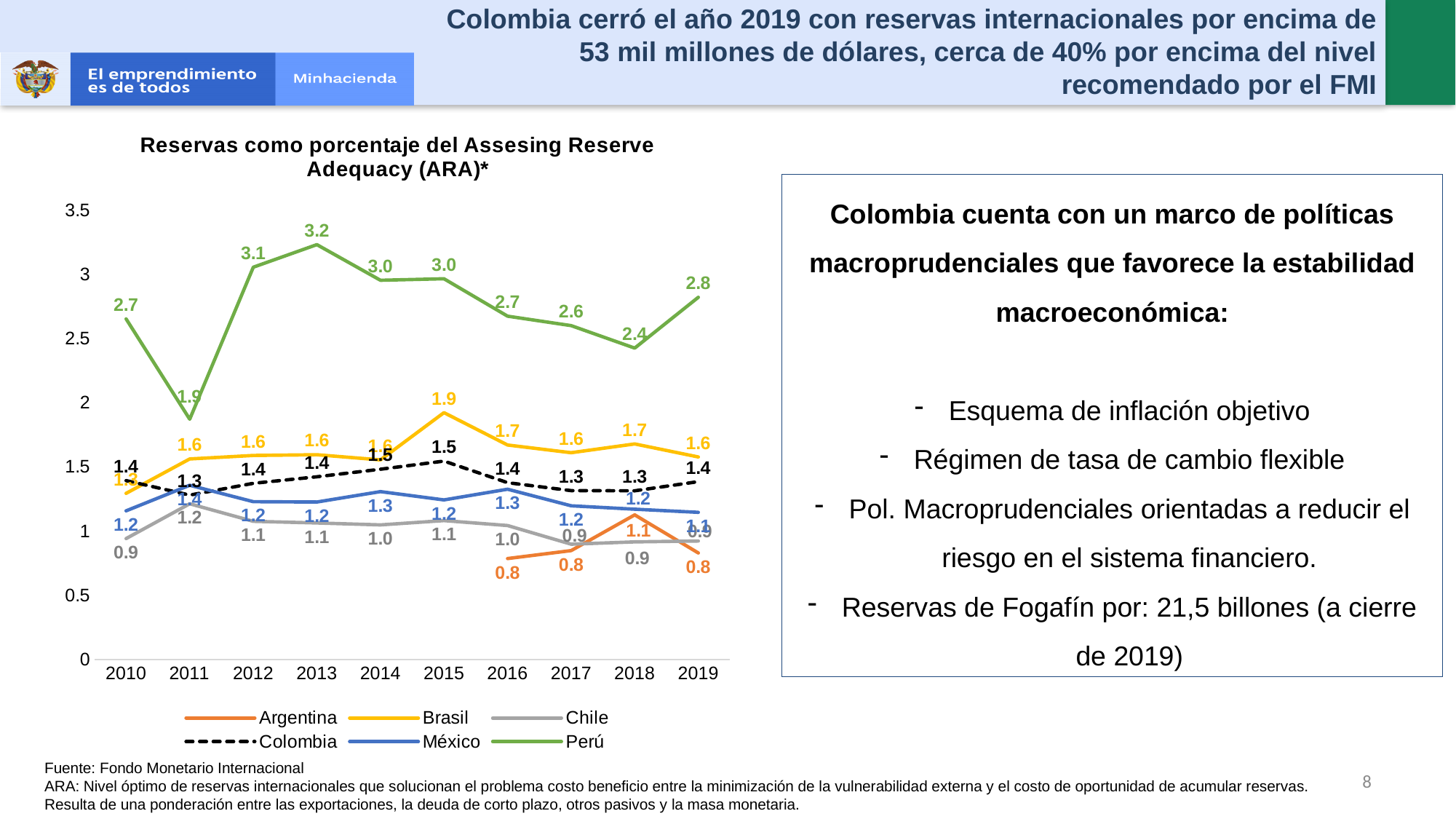
In which year does Perú have its lowest value? 2011 Do Perú's values rise or fall from 2015 to 2018? fall What is the difference between Perú's value in 2013 and its value in 2011? 1.3 How many years are shown on the x axis of the chart? 10 Which is larger in 2019, the value for Perú or the value for Brasil? Perú What is the value for Brasil in 2015? 1.9 What is the value for Argentina in 2018? 1.1 What is the value for Perú in 2013? 3.2 How many series does the legend of the chart list? 6 What is the value for Colombia in 2019? 1.4 What kind of chart is shown on the slide? line chart In which year does Perú reach its highest value? 2013